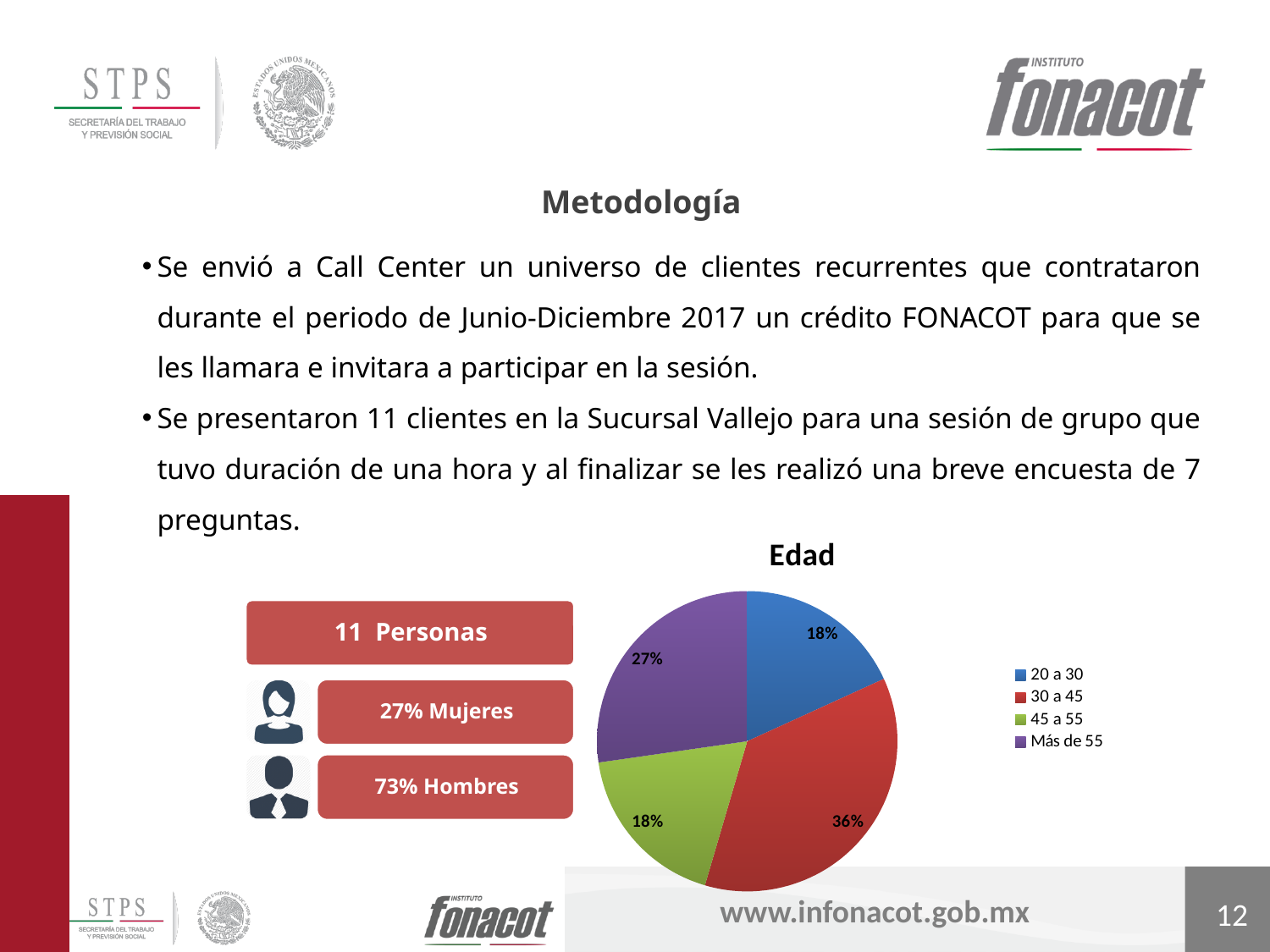
In the "Edad" pie chart, which is larger: the share for "Más de 55" or the share for "20 a 30"? Más de 55 In the "Edad" pie chart, what share is shown for the "30 a 45" slice? 36% In the "Edad" pie chart, what share is shown for the "45 a 55" slice? 18% In the "Edad" pie chart, what share is shown for the "20 a 30" slice? 18% In the "Edad" pie chart, how many entries does the legend list? 4 In the "Edad" pie chart, what is the difference in percentage points between the "30 a 45" slice and the "Más de 55" slice? 9 percentage points In the "Edad" pie chart, what share is shown for the "Más de 55" slice? 27% In the "Edad" pie chart, which colour represents the "30 a 45" slice? red In the "Edad" pie chart, how many slices (age groups) are there? 4 What kind of chart is the "Edad" chart? pie chart What is the title of the pie chart on the slide? Edad In the "Edad" pie chart, which age group has the largest share? 30 a 45